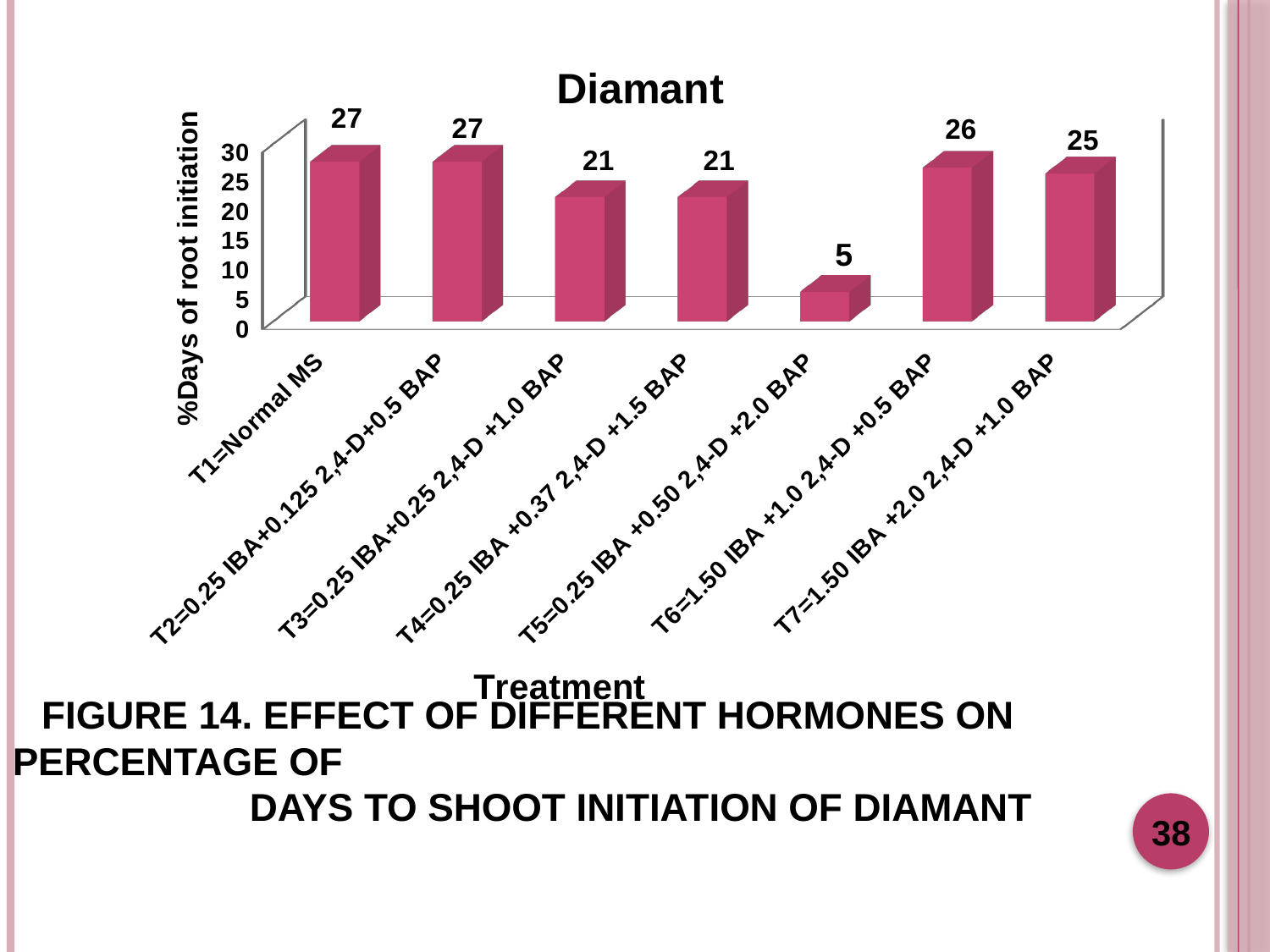
What is the value for T5=0.25 IBA +0.50 2,4-D +2.0 BAP? 5 What is the title of the chart? Diamant What is the value for T1=Normal MS? 27 What is the value for T7=1.50 IBA +2.0 2,4-D +1.0 BAP? 25 What is the difference between the values for T1=Normal MS and T5=0.25 IBA +0.50 2,4-D +2.0 BAP? 22 What is the value for T6=1.50 IBA +1.0 2,4-D +0.5 BAP? 26 Is the value for T4=0.25 IBA +0.37 2,4-D +1.5 BAP greater or less than 25? less How many treatments are shown on the chart? 7 Which treatment has the lowest value? T5=0.25 IBA +0.50 2,4-D +2.0 BAP What kind of chart is shown on the slide? bar chart Which is larger, the value for T6=1.50 IBA +1.0 2,4-D +0.5 BAP or T7=1.50 IBA +2.0 2,4-D +1.0 BAP? T6=1.50 IBA +1.0 2,4-D +0.5 BAP What is the difference between the values for T6=1.50 IBA +1.0 2,4-D +0.5 BAP and T3=0.25 IBA+0.25 2,4-D +1.0 BAP? 5